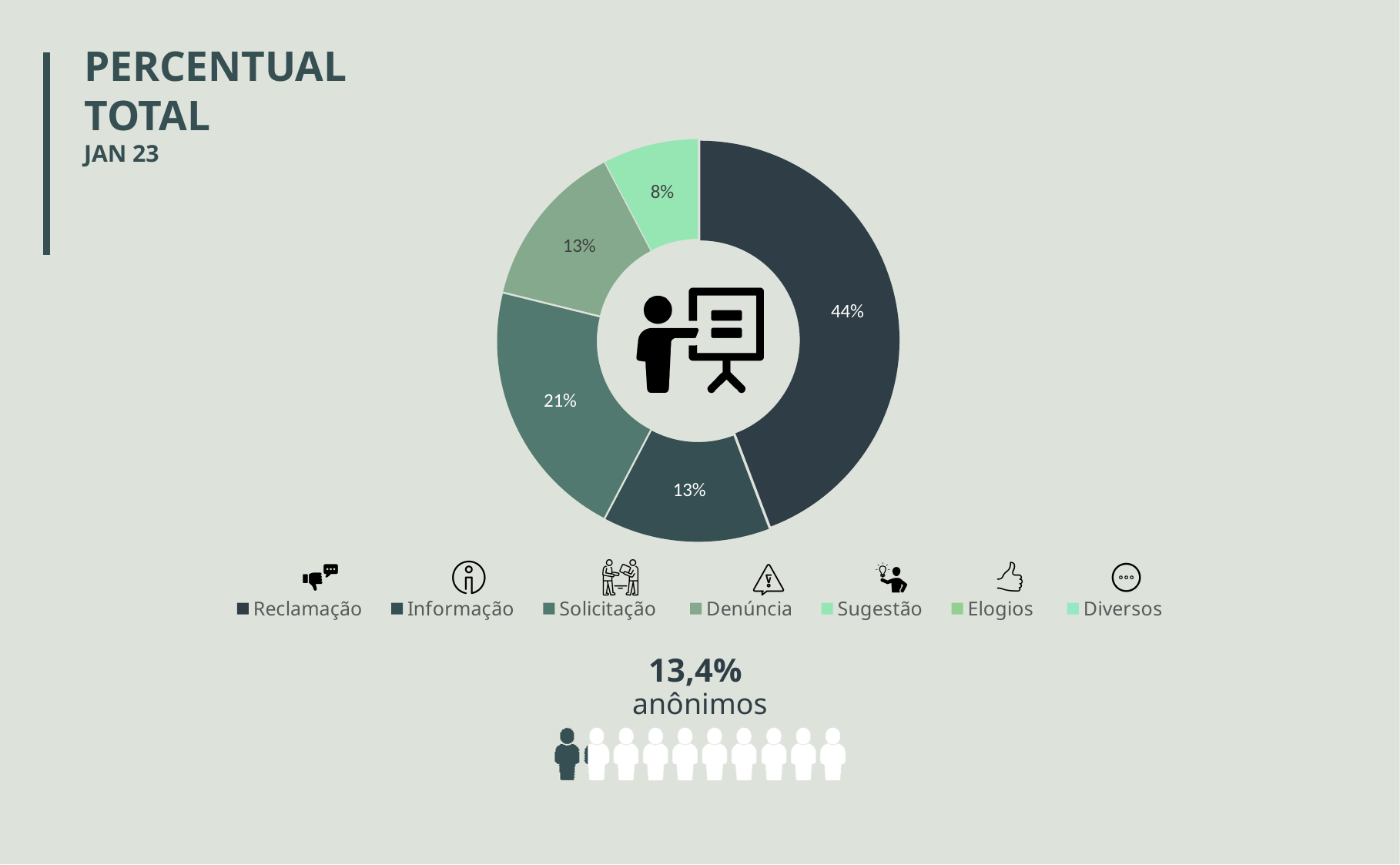
What percentage is shown for Informação? 13% Which is larger, Solicitação or Denúncia? Solicitação Which category has the largest share of the pie? Reclamação How many slices with data labels are visible on the pie? 5 What percentage is shown for Solicitação? 21% What period does the chart title refer to? JAN 23 What is the smallest percentage labelled on the pie? 8% What kind of chart is shown on the slide? pie (donut) chart What percentage is shown for Reclamação? 44% How many entries does the legend list? 7 How many percentage points larger is Reclamação than Solicitação? 23 What percentage is shown for Denúncia? 13%